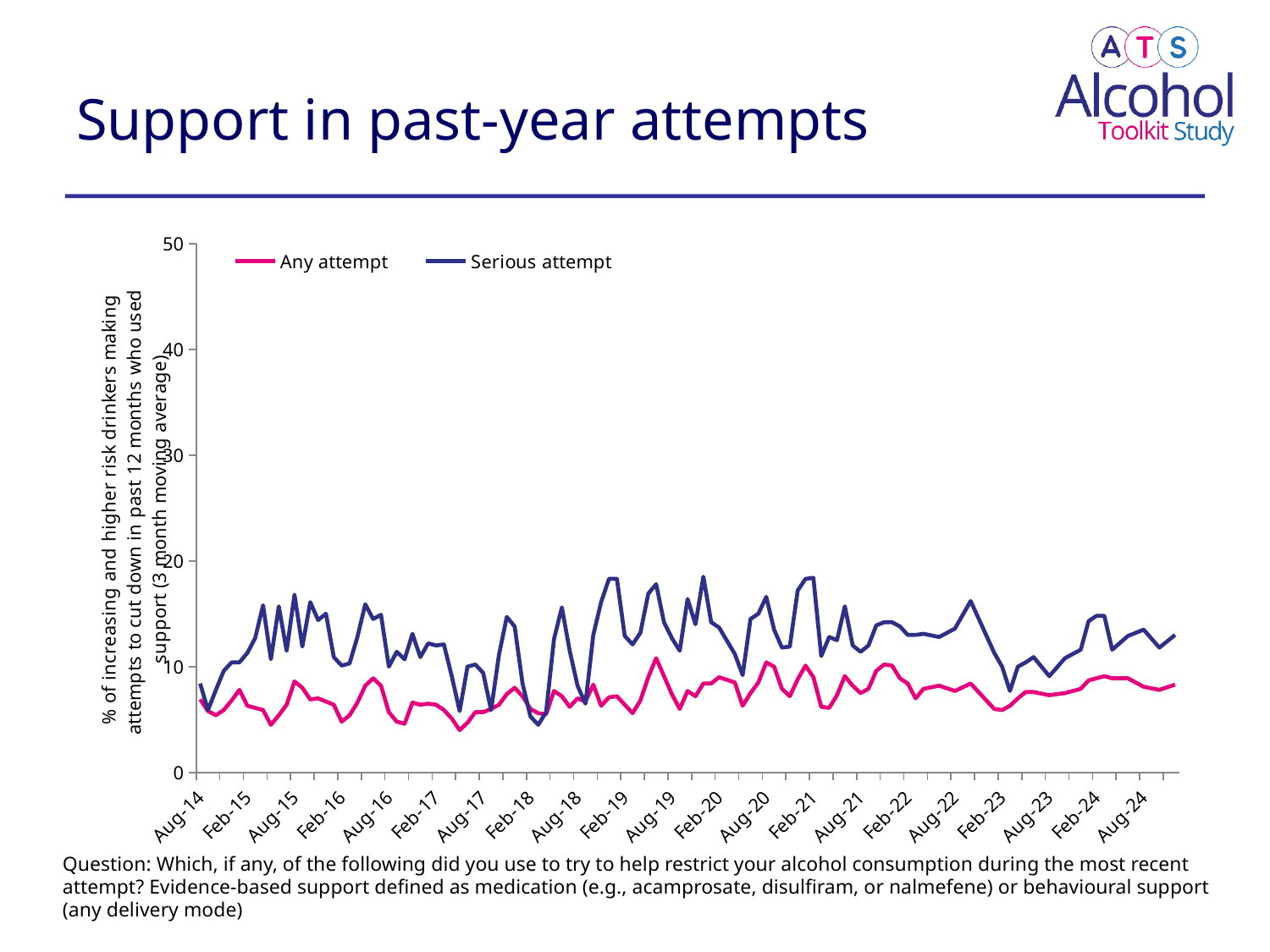
What colour is the line for the Any attempt series? Pink What kind of chart is shown on the slide? Line chart Is the value for Any attempt at Aug-17 greater or less than 10? less Does the Any attempt line ever rise above 20 on the chart? No Is the value for Serious attempt at Aug-19 greater or less than 10? greater What is the highest value shown on the y axis? 50 How many series does the legend list? 2 At Feb-19, which series has the larger value, Any attempt or Serious attempt? Serious attempt Does the Serious attempt line rise or fall between Aug-22 and Feb-23? Fall What are the two series named in the legend? Any attempt and Serious attempt Which series is higher across most of the period shown? Serious attempt